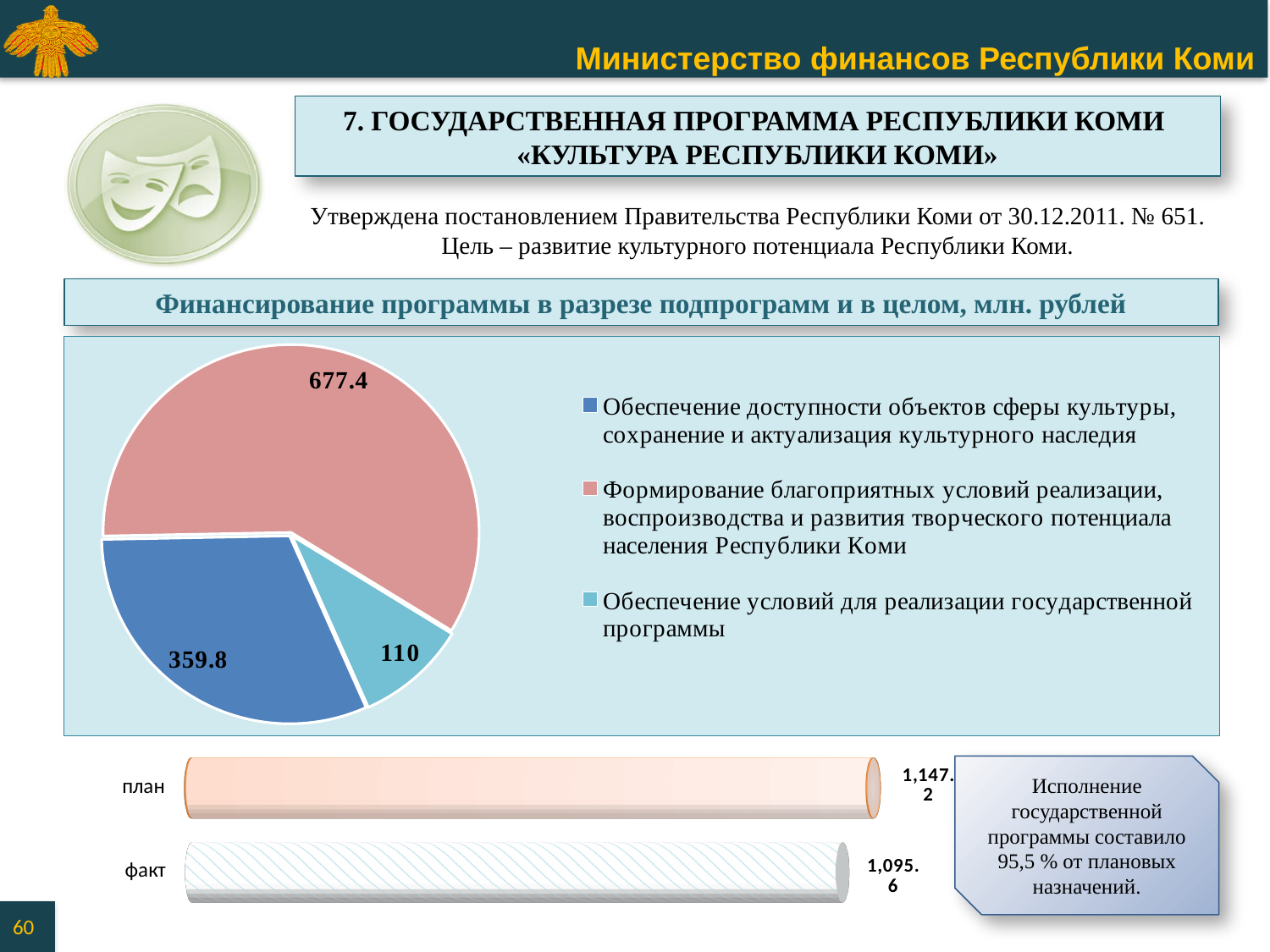
In the pie chart, which subprogram has the largest slice? Формирование благоприятных условий реализации, воспроизводства и развития творческого потенциала населения Республики Коми What kind of chart is shown in the upper chart area of the slide? Pie chart In the pie chart, what is the value for 'Обеспечение доступности объектов сферы культуры, сохранение и актуализация культурного наследия'? 359.8 In the pie chart, what is the difference between the largest slice (677.4) and the slice valued 359.8? 317.6 In the bar chart at the bottom of the slide, which is larger, 'план' or 'факт'? план In the pie chart, which subprogram has the smallest slice? Обеспечение условий для реализации государственной программы In the pie chart, what is the value for the slice 'Формирование благоприятных условий реализации, воспроизводства и развития творческого потенциала населения Республики Коми'? 677.4 In the bar chart at the bottom of the slide, what is the value for 'план'? 1,147.2 In the bar chart at the bottom of the slide, what is the value for 'факт'? 1,095.6 How many slices does the pie chart have? 3 How many entries does the pie chart's legend list? 3 In the pie chart, what is the value for 'Обеспечение условий для реализации государственной программы'? 110